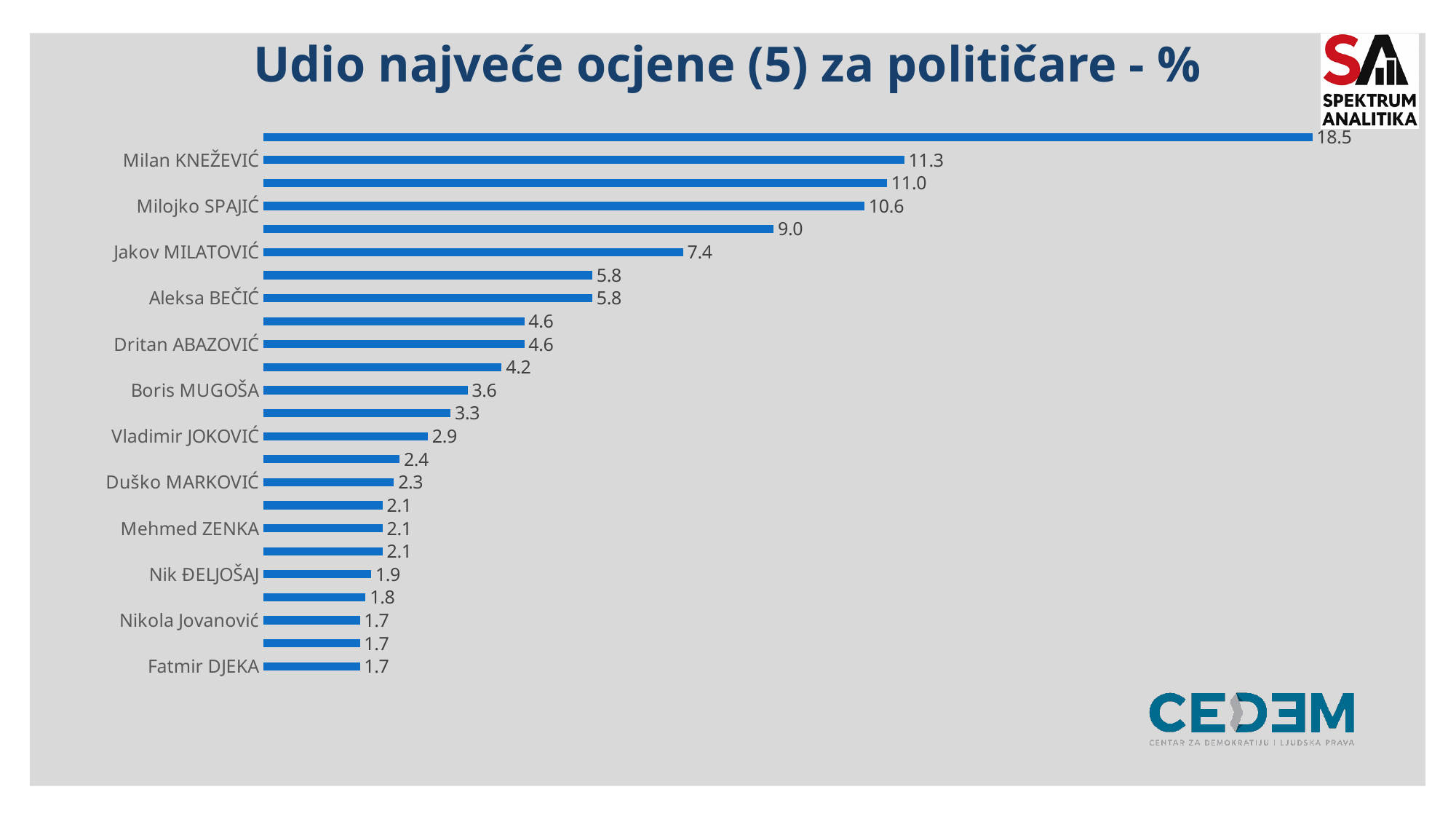
What is the value for Boris MUGOŠA? 3.6 Which has a larger value, Dritan ABAZOVIĆ or Boris MUGOŠA? Dritan ABAZOVIĆ What is the value for Jakov MILATOVIĆ? 7.4 What is the lowest value shown on the chart? 1.7 What is the value for Milan KNEŽEVIĆ? 11.3 What is the value for Nik ĐELJOŠAJ? 1.9 What kind of chart is shown on the slide? bar chart How many bars are plotted on the chart? 24 What is the value for Milojko SPAJIĆ? 10.6 What is the title of the chart? Udio najveće ocjene (5) za političare - % What is the highest value shown on the chart? 18.5 What is the difference between the values for Milan KNEŽEVIĆ and Milojko SPAJIĆ? 0.7